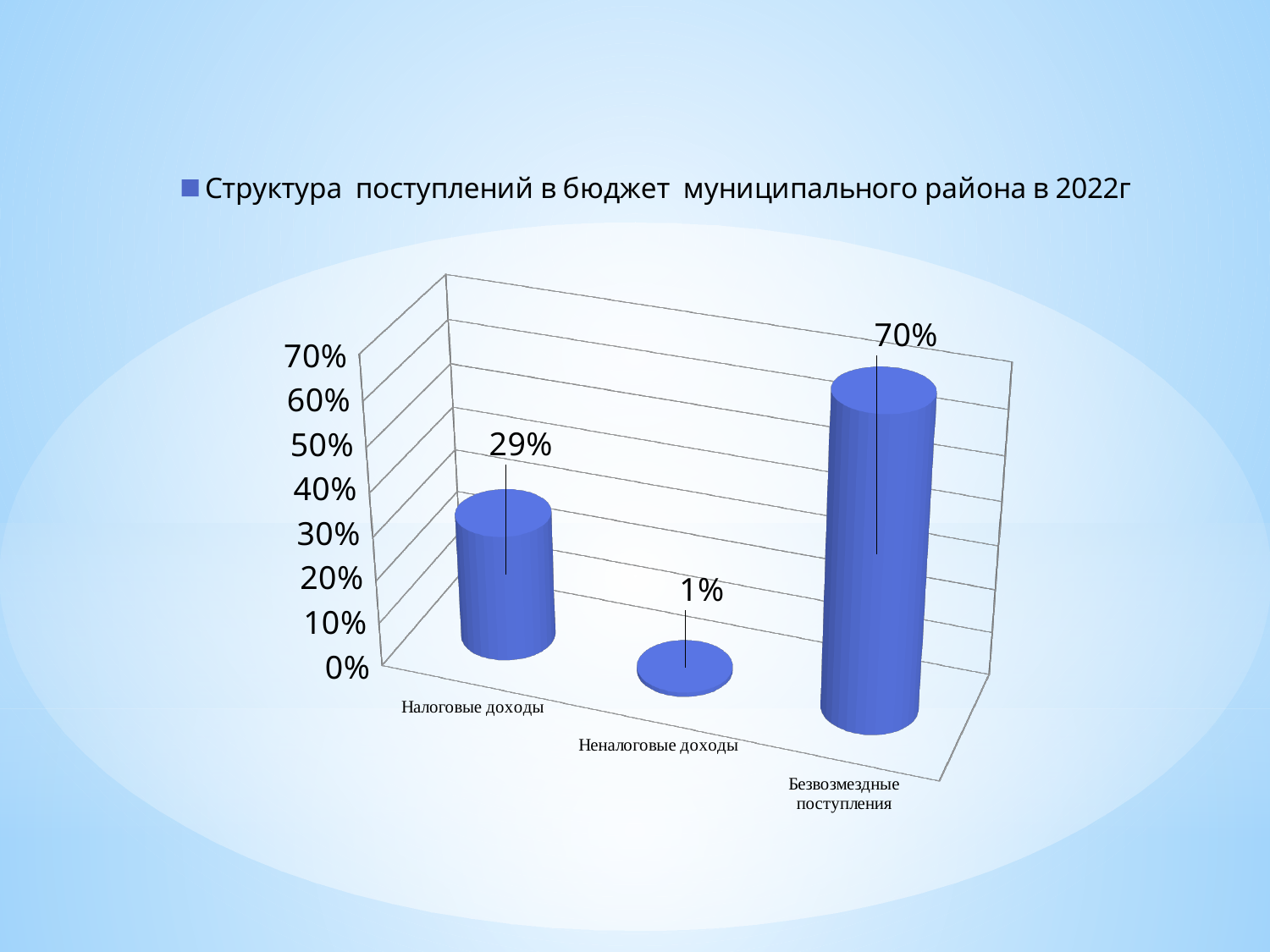
How many categories are shown on the chart? 3 How many series does the legend list? 1 Which is larger, the value for Налоговые доходы or the value for Безвозмездные поступления? Безвозмездные поступления What is the value for Налоговые доходы? 29% What is the value for Безвозмездные поступления? 70% What is the legend entry of the chart? Структура поступлений в бюджет муниципального района в 2022г What is the difference between the values for Налоговые доходы and Неналоговые доходы? 28% Which category has the highest value? Безвозмездные поступления What is the value for Неналоговые доходы? 1% What kind of chart is shown on the slide? Bar chart What is the difference between the values for Безвозмездные поступления and Налоговые доходы? 41% Which category has the lowest value? Неналоговые доходы